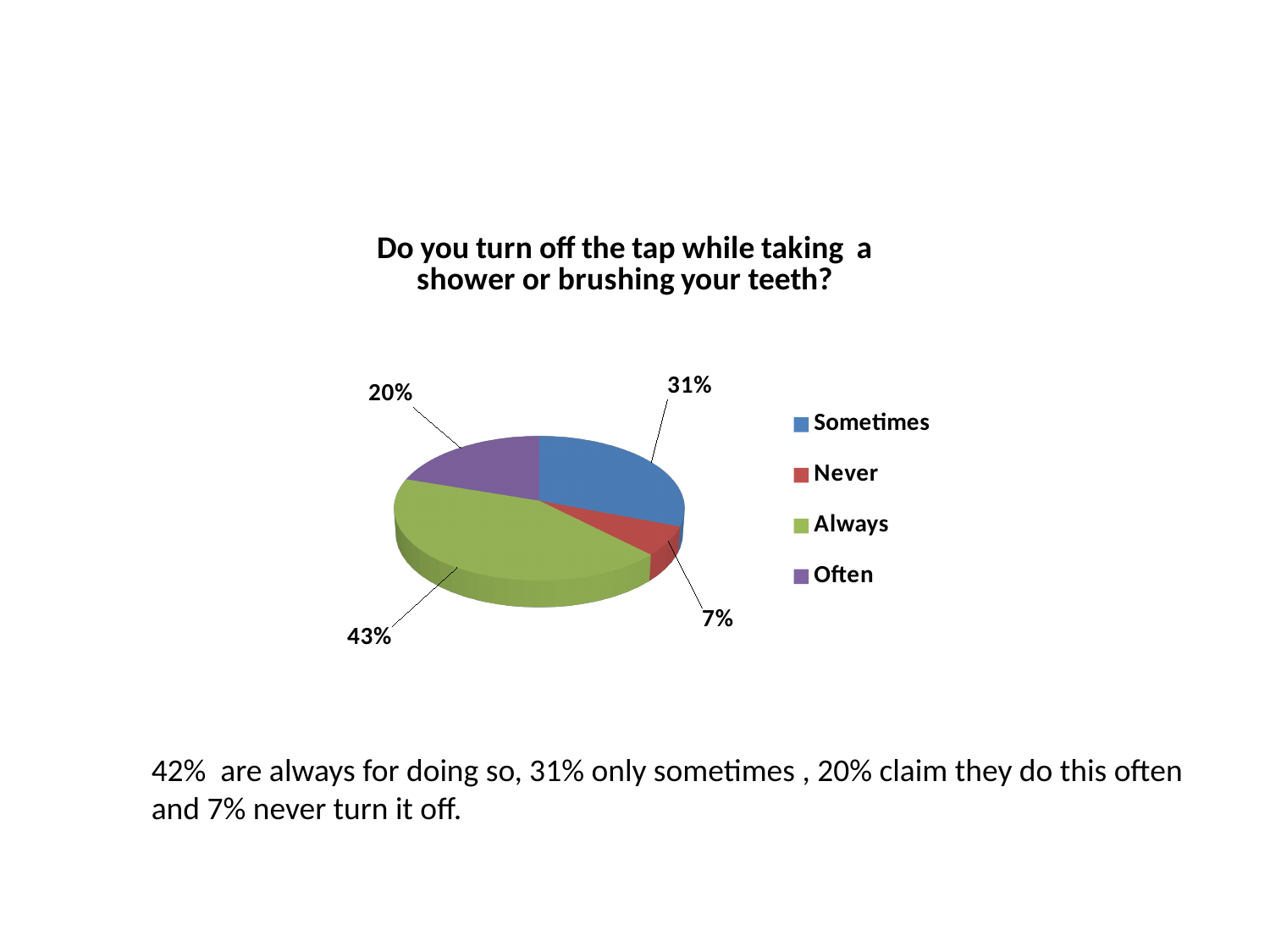
What is the title of the chart? Do you turn off the tap while taking a shower or brushing your teeth? What percentage is shown for the Often slice? 20% What kind of chart is shown on the slide? Pie chart Which category has the largest share of the pie? Always What percentage is shown for the Sometimes slice? 31% What is the difference in percentage points between the Always and Sometimes slices? 12 What percentage of the pie is labelled for the Always slice? 43% What colour is the Always slice? Green Which category has the smallest share of the pie? Never How many categories does the legend list? 4 What percentage is shown for the Never slice? 7% Which slice is larger, Often or Never? Often